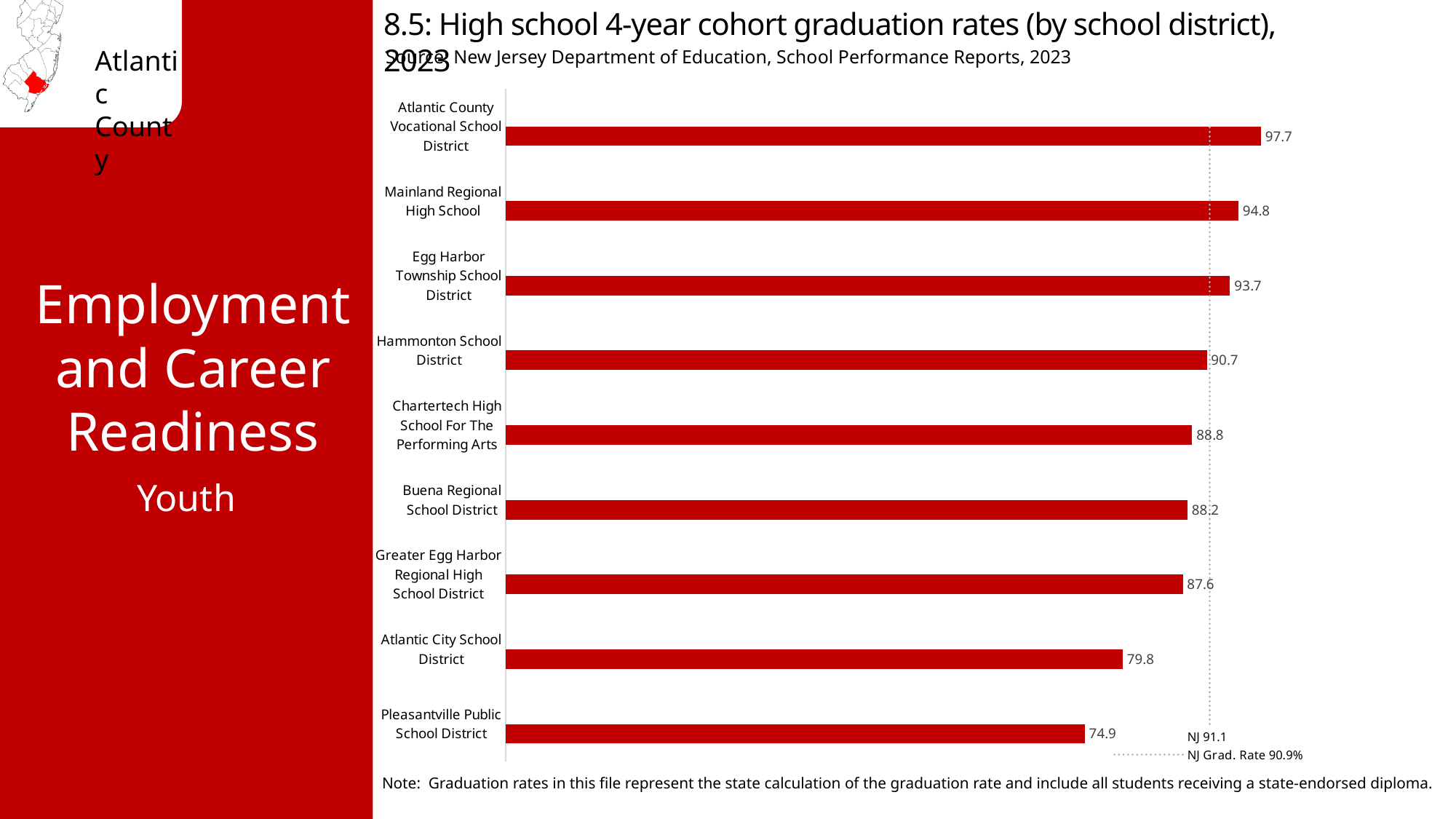
What is the difference between the graduation rates of Mainland Regional High School and Atlantic City School District? 15.0 What is the graduation rate for Pleasantville Public School District? 74.9 Which school district has the highest graduation rate? Atlantic County Vocational School District Which school district has the lowest graduation rate? Pleasantville Public School District What is the graduation rate for Atlantic City School District? 79.8 Which has a higher graduation rate, Egg Harbor Township School District or Buena Regional School District? Egg Harbor Township School District How many school districts are shown in the chart? 9 What is the graduation rate for Hammonton School District? 90.7 What type of chart is shown on the slide? Bar chart What is the graduation rate for Atlantic County Vocational School District? 97.7 What is the difference between the graduation rates of Atlantic County Vocational School District and Pleasantville Public School District? 22.8